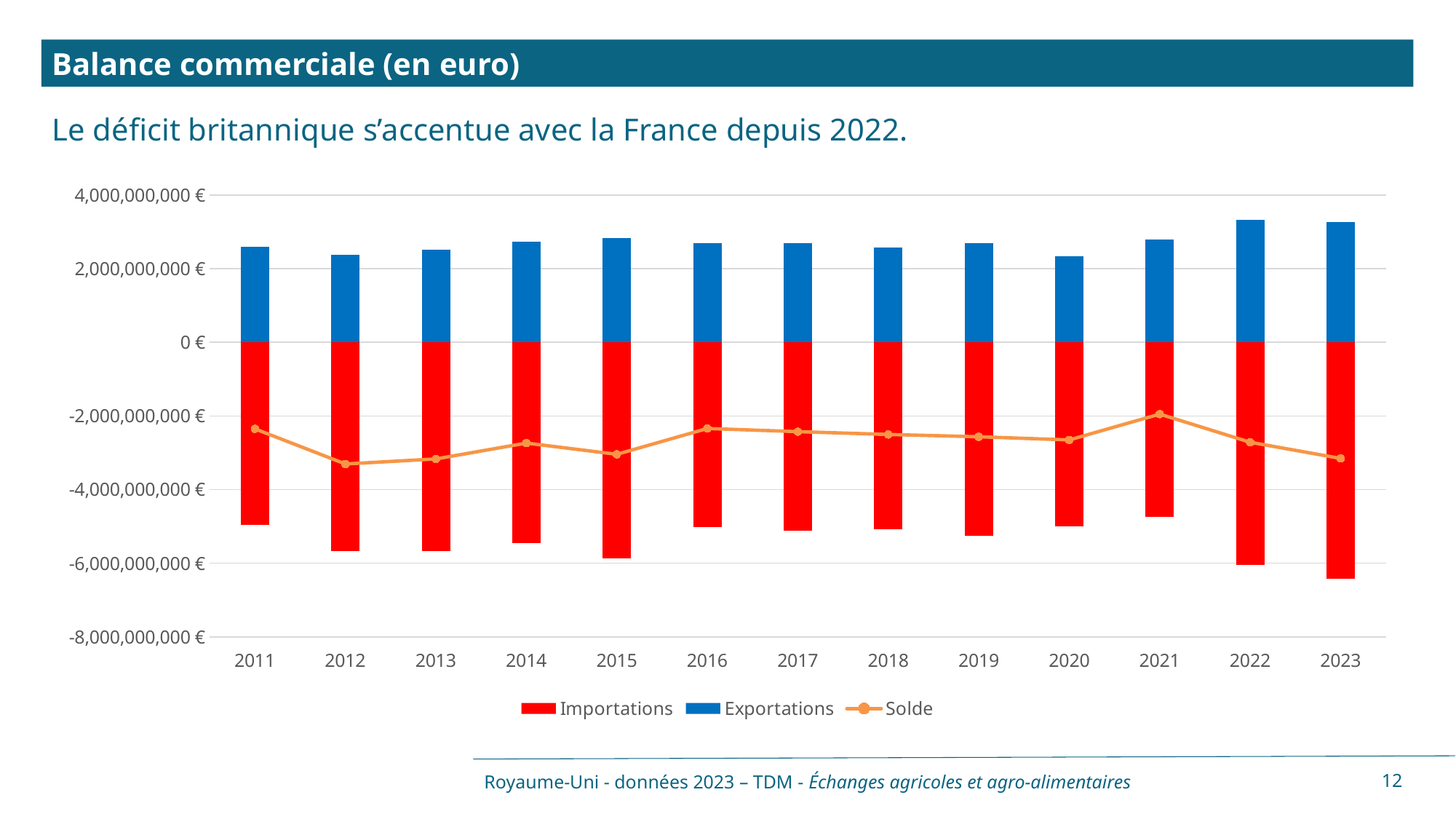
Is the Solde value for 2012 greater or less than -2,000,000,000 €? less How many series does the legend list? 3 Which series is drawn as a line with markers? Solde Is the Importations value for 2021 greater or less than -6,000,000,000 €? greater In which year is the Solde line at its highest (least negative) point? 2021 Which year has the larger Exportations value, 2020 or 2022? 2022 How many years are shown on the x axis of the chart? 13 Is the Exportations value for 2022 greater or less than 2,000,000,000 €? greater In which year does the Importations bar reach its lowest (most negative) value? 2023 What colour are the Importations bars? Red What kind of chart is shown on the slide? A bar chart combined with a line